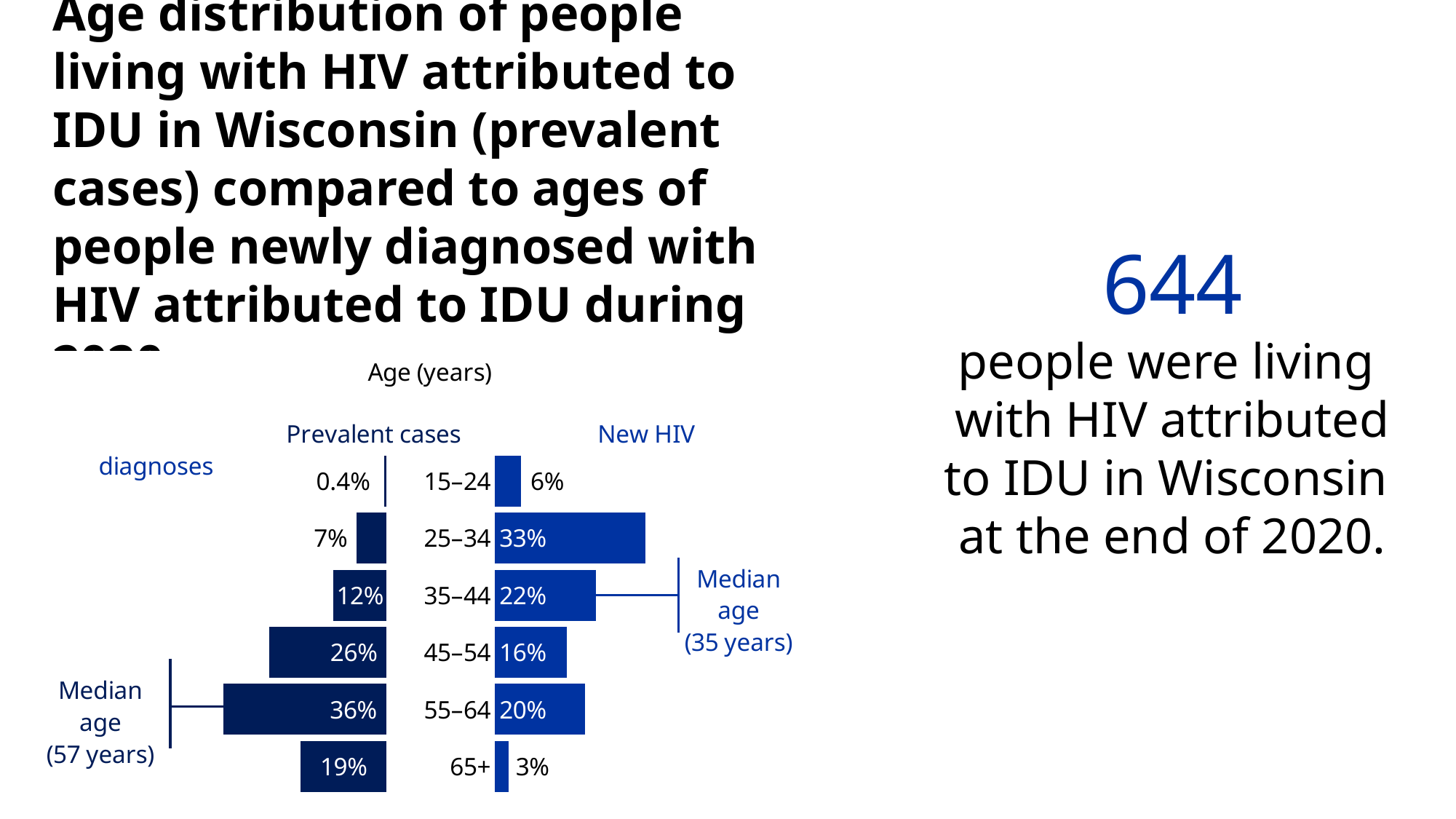
Which age group has the highest share of prevalent cases? 55–64 What percentage of new HIV diagnoses are in the 25–34 age group? 33% How many age groups are shown in the chart? 6 For the 35–44 age group, which is larger: the share of prevalent cases or the share of new HIV diagnoses? New HIV diagnoses Which age group has the highest share of new HIV diagnoses? 25–34 What kind of chart is shown on the slide? Bar chart What is the difference between the prevalent cases share and the new HIV diagnoses share for the 45–54 age group? 10% What percentage of prevalent cases are in the 15–24 age group? 0.4% What is the median age of prevalent cases shown on the chart? 57 years What percentage of prevalent cases are in the 55–64 age group? 36% How many series does the chart compare? 2 Which age group has the lowest share of new HIV diagnoses? 65+